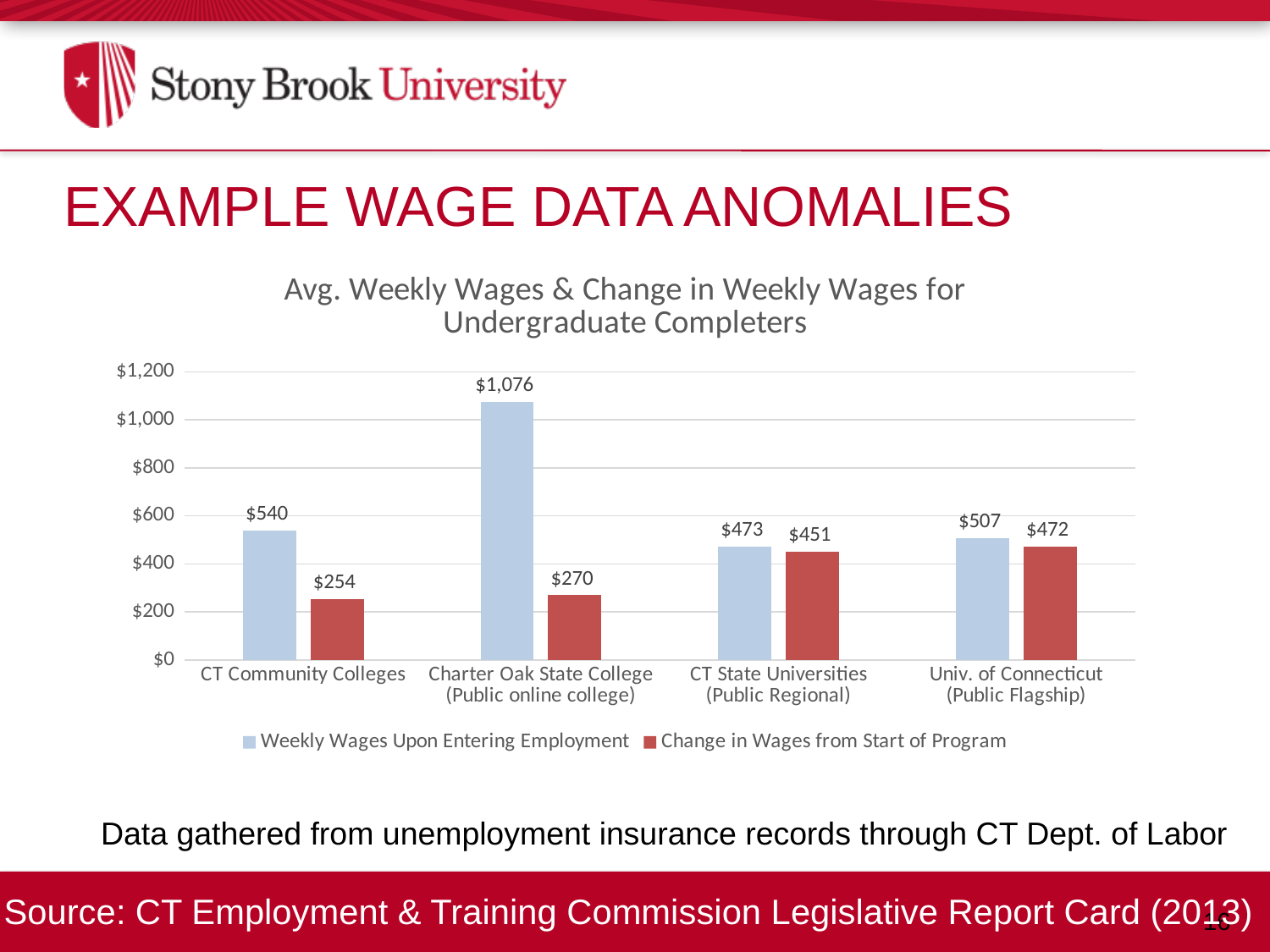
Which category has the lowest Change in Wages from Start of Program? CT Community Colleges How many categories are shown on the x axis? 4 Which category has the highest Weekly Wages Upon Entering Employment? Charter Oak State College (Public online college) What is the Change in Wages from Start of Program for CT Community Colleges? $254 How many series does the legend list? 2 What is the title of the chart? Avg. Weekly Wages & Change in Weekly Wages for Undergraduate Completers Is the Weekly Wages Upon Entering Employment for CT Community Colleges greater or less than $600? less What kind of chart is shown on the slide? bar chart What is the difference between Weekly Wages Upon Entering Employment and Change in Wages from Start of Program for CT State Universities (Public Regional)? $22 What is the value of Weekly Wages Upon Entering Employment for Univ. of Connecticut (Public Flagship)? $507 What is the value of Weekly Wages Upon Entering Employment for Charter Oak State College (Public online college)? $1,076 Which is larger: the Change in Wages from Start of Program for Univ. of Connecticut (Public Flagship) or for Charter Oak State College (Public online college)? Univ. of Connecticut (Public Flagship)